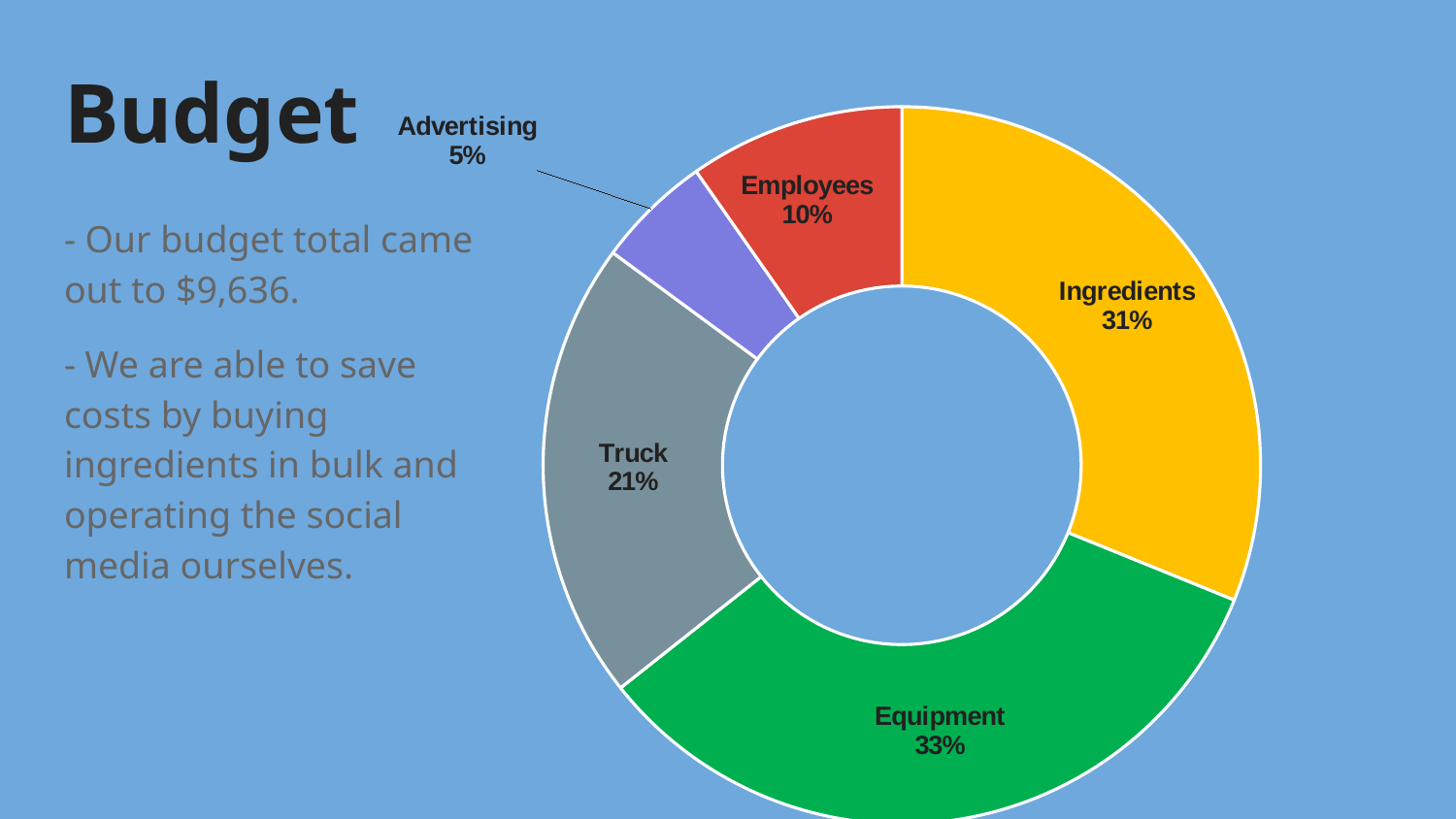
What is the combined share of Ingredients and Equipment? 64% What colour is the Truck segment of the chart? Grey What percentage of the budget is allocated to Truck? 21% How many categories are shown in the budget chart? 5 What percentage does Employees account for in the budget chart? 10% Which category has the largest share of the budget? Equipment What share of the budget is Advertising? 5% Which has a larger share of the budget, Employees or Truck? Truck What share of the budget goes to Ingredients? 31% What kind of chart is used to show the budget? Doughnut (pie) chart What is the difference in percentage points between Equipment and Truck? 12 Which category has the smallest share of the budget? Advertising